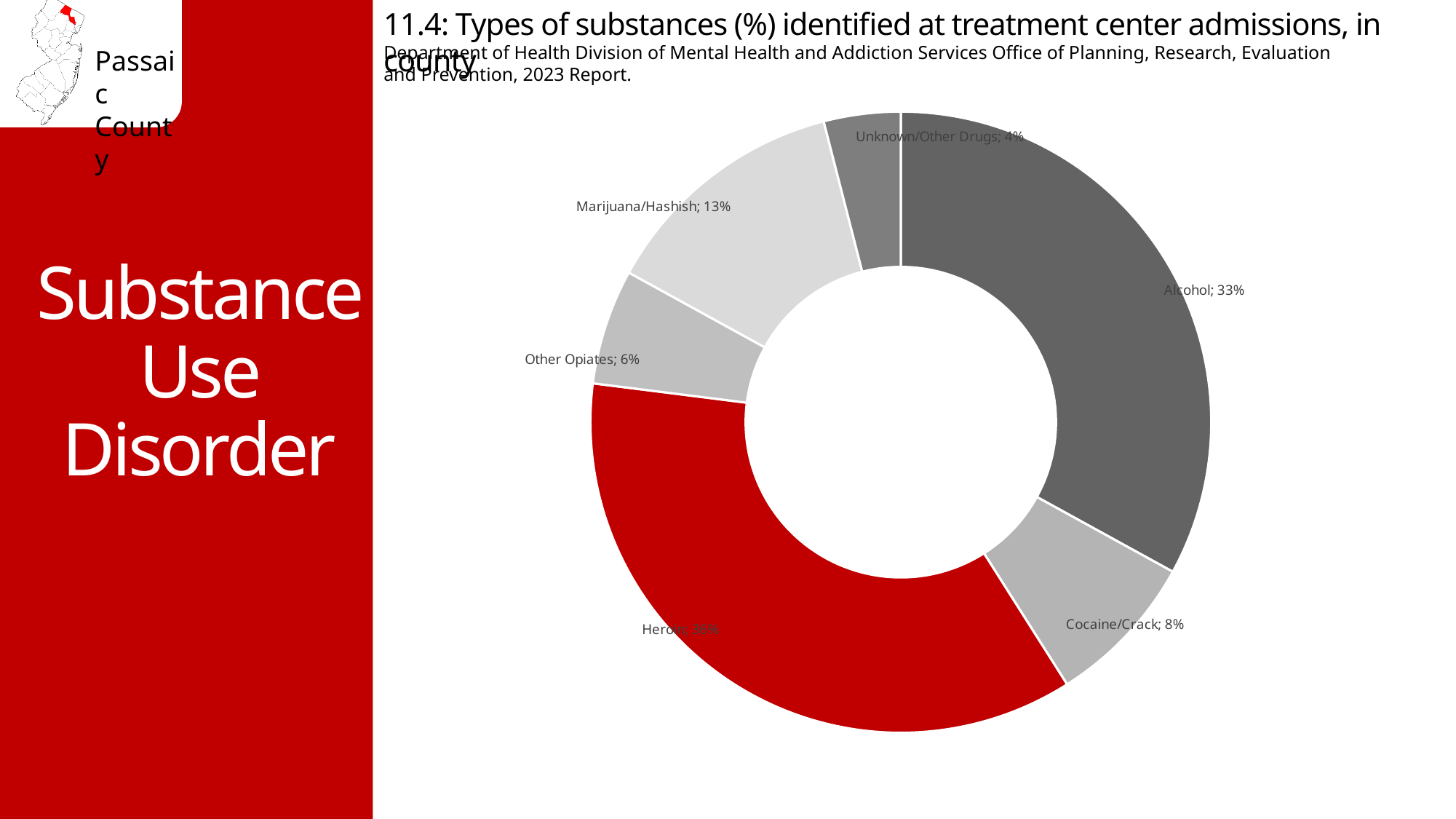
Which segment of the chart is coloured red? Heroin What percentage of treatment center admissions is attributed to Alcohol? 33% Which substance has the largest share of treatment center admissions? Heroin Which is larger, the share for Cocaine/Crack or the share for Other Opiates? Cocaine/Crack Which substance has the smallest share of treatment center admissions? Unknown/Other Drugs What percentage is shown for Unknown/Other Drugs? 4% What kind of chart is used to show the types of substances? Doughnut chart How many substance categories are shown in the chart? 6 What percentage is shown for Cocaine/Crack? 8% What is the difference in percentage points between Alcohol and Marijuana/Hashish? 20 What percentage is shown for Other Opiates? 6% What percentage is shown for Marijuana/Hashish? 13%